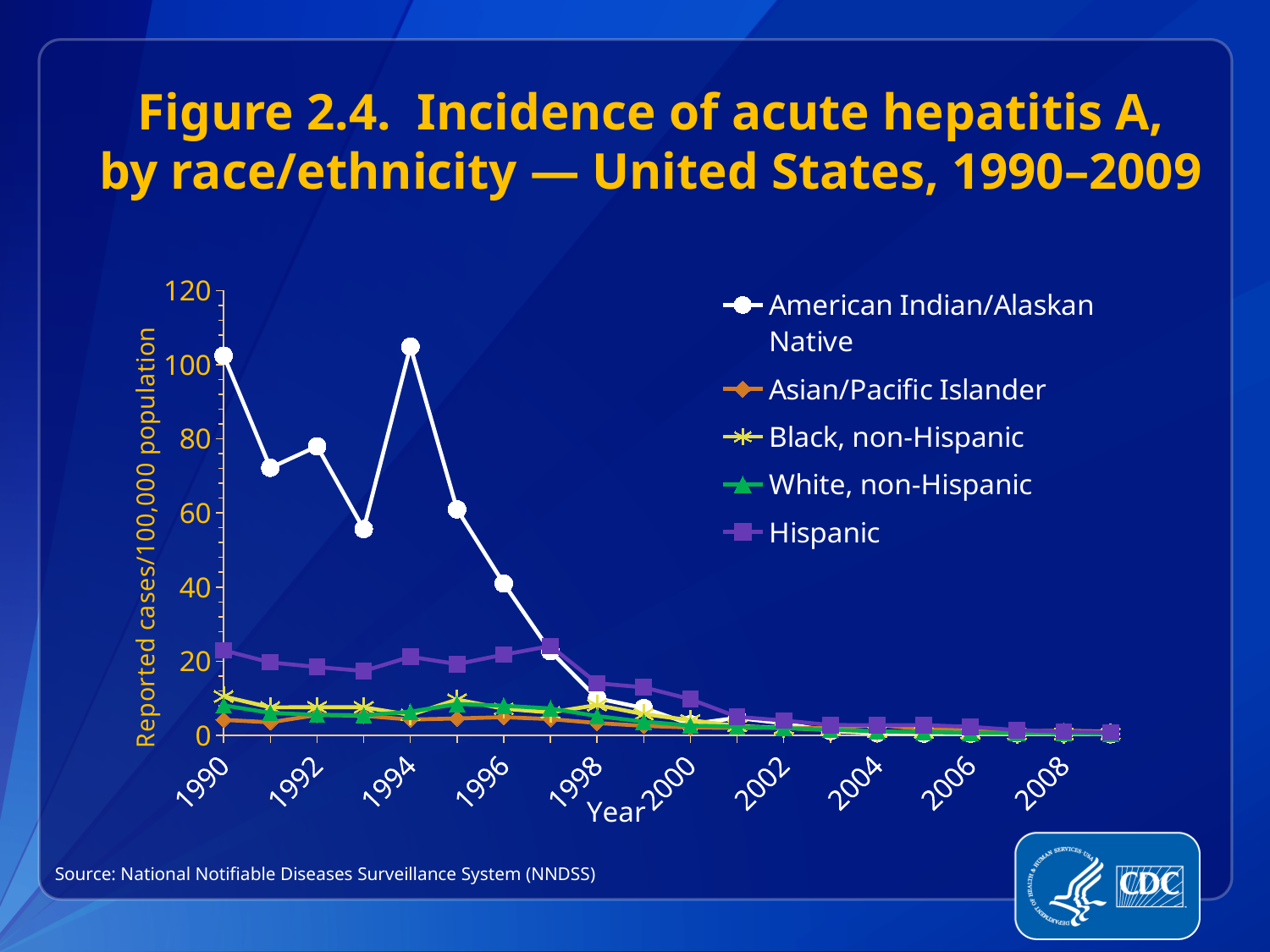
Which race/ethnicity group has the highest incidence in 1990? American Indian/Alaskan Native Is the value for Hispanic in 1990 greater or less than 40? less For American Indian/Alaskan Native, which year has the larger value, 1993 or 1994? 1994 Overall, does the American Indian/Alaskan Native incidence rise or fall from 1990 to 2009? fall How many years (data points per series) are plotted along the x axis? 20 Which series is plotted with square markers? Hispanic What kind of chart is shown on the slide? line chart Is the value for American Indian/Alaskan Native in 1993 greater or less than 80? less Is the value for American Indian/Alaskan Native in 1990 greater or less than 80? greater How many series does the legend list? 5 What is the label on the y axis? Reported cases/100,000 population